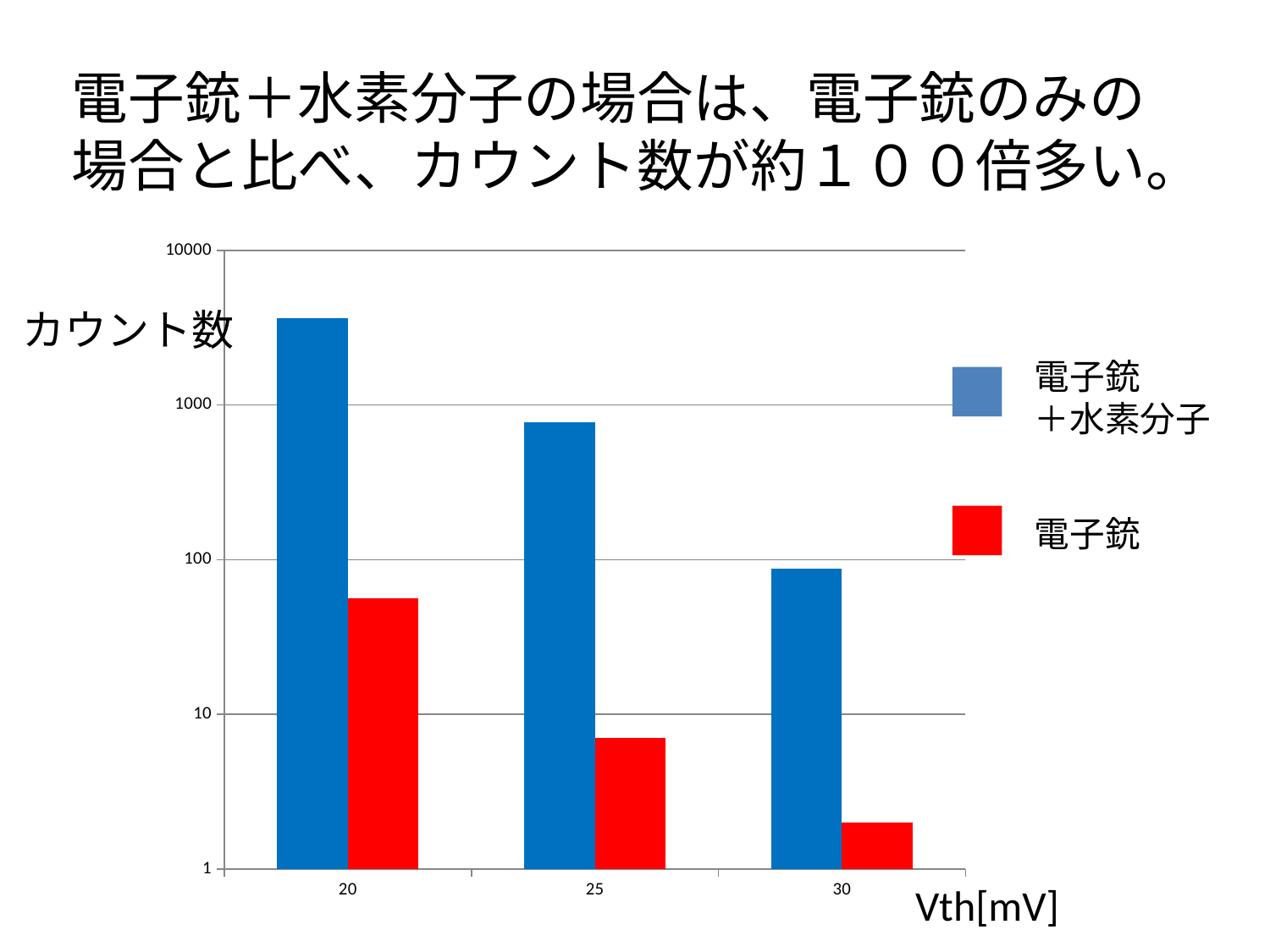
At which Vth value is the 電子銃 count lowest? 30 What is the label of the x axis? Vth[mV] How many series does the legend list? 2 Is the 電子銃＋水素分子 count at Vth = 20 greater or less than 1000? greater At which Vth value is the 電子銃＋水素分子 count highest? 20 Which colour represents the 電子銃 series in the legend? red Is the 電子銃 count at Vth = 25 greater or less than 10? less Do the 電子銃＋水素分子 counts rise or fall as Vth increases from 20 to 30? fall At Vth = 25, which series has the larger count, 電子銃＋水素分子 or 電子銃? 電子銃＋水素分子 Is the 電子銃 count at Vth = 20 greater or less than 10? greater How many Vth categories are shown on the x axis? 3 What kind of chart is shown on the slide? bar chart